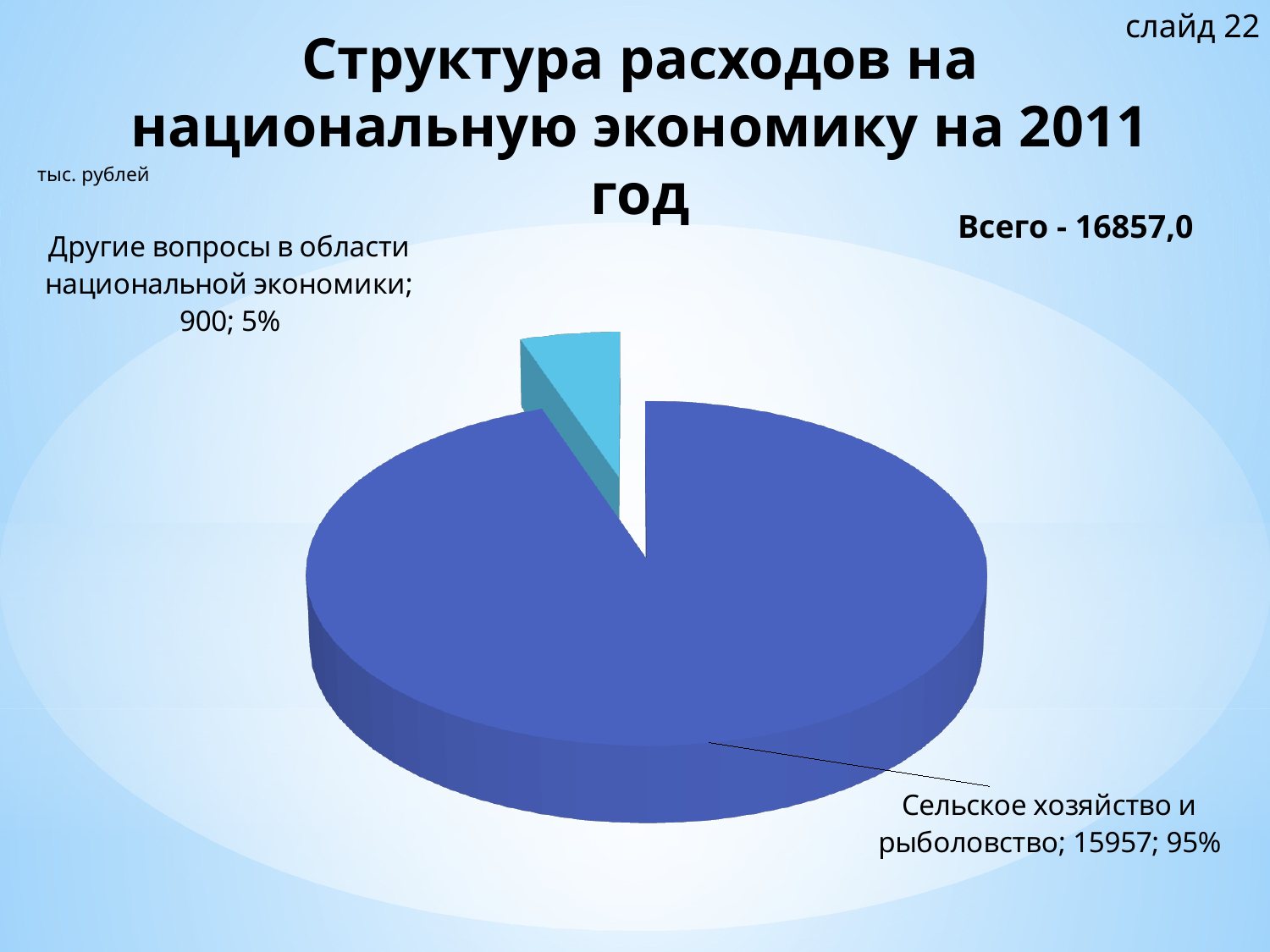
Which category has the smallest slice? Другие вопросы в области национальной экономики What share of the pie does Другие вопросы в области национальной экономики represent? 5% What is the value for Сельское хозяйство и рыболовство? 15957 Which is larger: Сельское хозяйство и рыболовство or Другие вопросы в области национальной экономики? Сельское хозяйство и рыболовство What total is stated on the slide (Всего)? 16857,0 What is the difference between the values for Сельское хозяйство и рыболовство and Другие вопросы в области национальной экономики? 15057 How many slices does the pie chart have? 2 What unit is indicated for the values on the slide? тыс. рублей What kind of chart is shown on the slide? pie chart What share of the pie does Сельское хозяйство и рыболовство represent? 95% Which category has the largest slice? Сельское хозяйство и рыболовство What is the value for Другие вопросы в области национальной экономики? 900